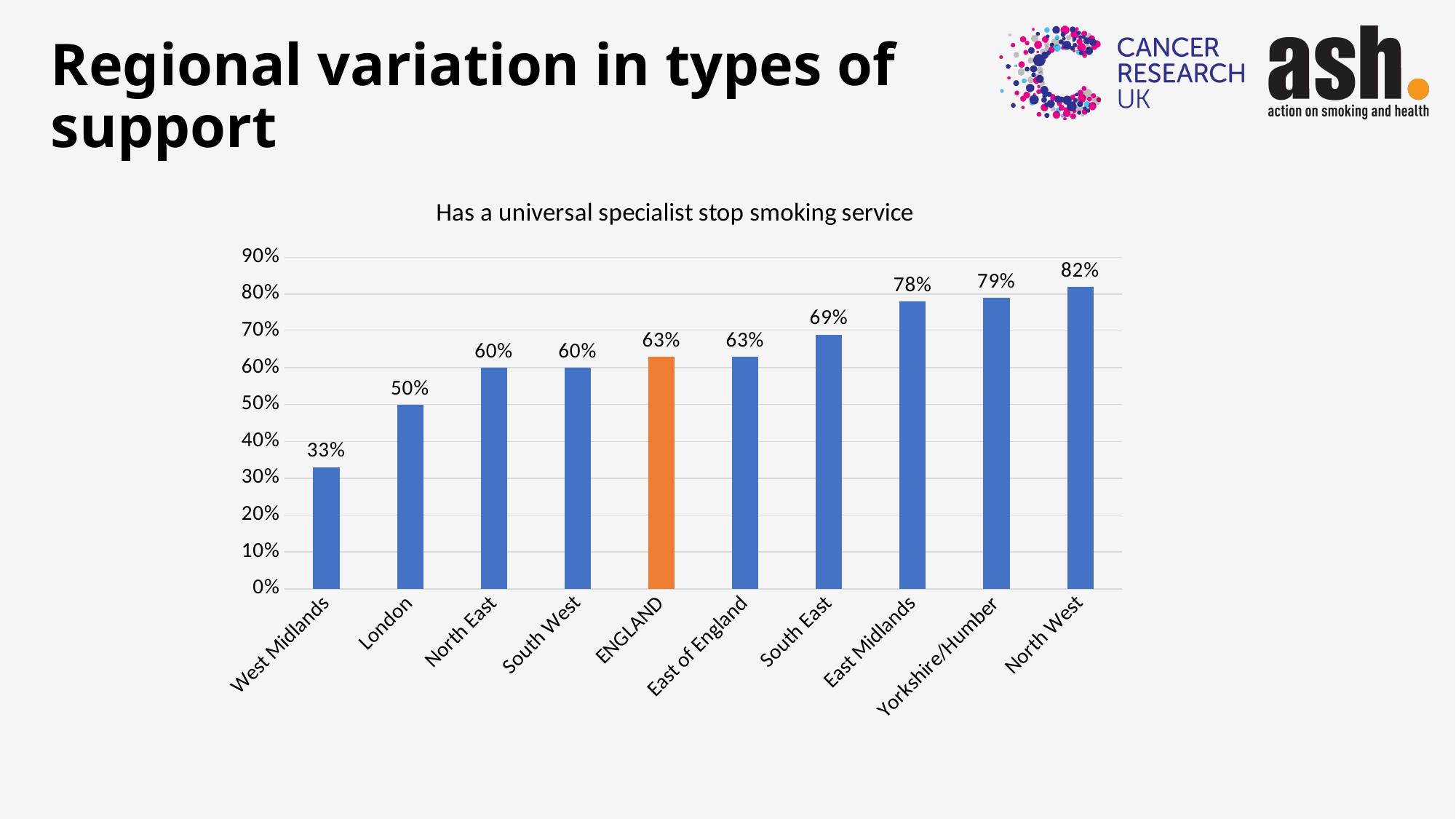
What is the value for ENGLAND? 63% How many categories are shown on the x axis? 10 What is the title of the chart? Has a universal specialist stop smoking service What is the difference between the values for East Midlands and London? 28% What is the value for Yorkshire/Humber? 79% What is the value for West Midlands? 33% Which is larger, the value for South East or the value for London? South East What kind of chart is shown? Bar chart Which region has the highest value? North West What is the difference between the values for North West and West Midlands? 49% Is the value for East Midlands greater or less than 70%? greater Which region has the lowest value? West Midlands